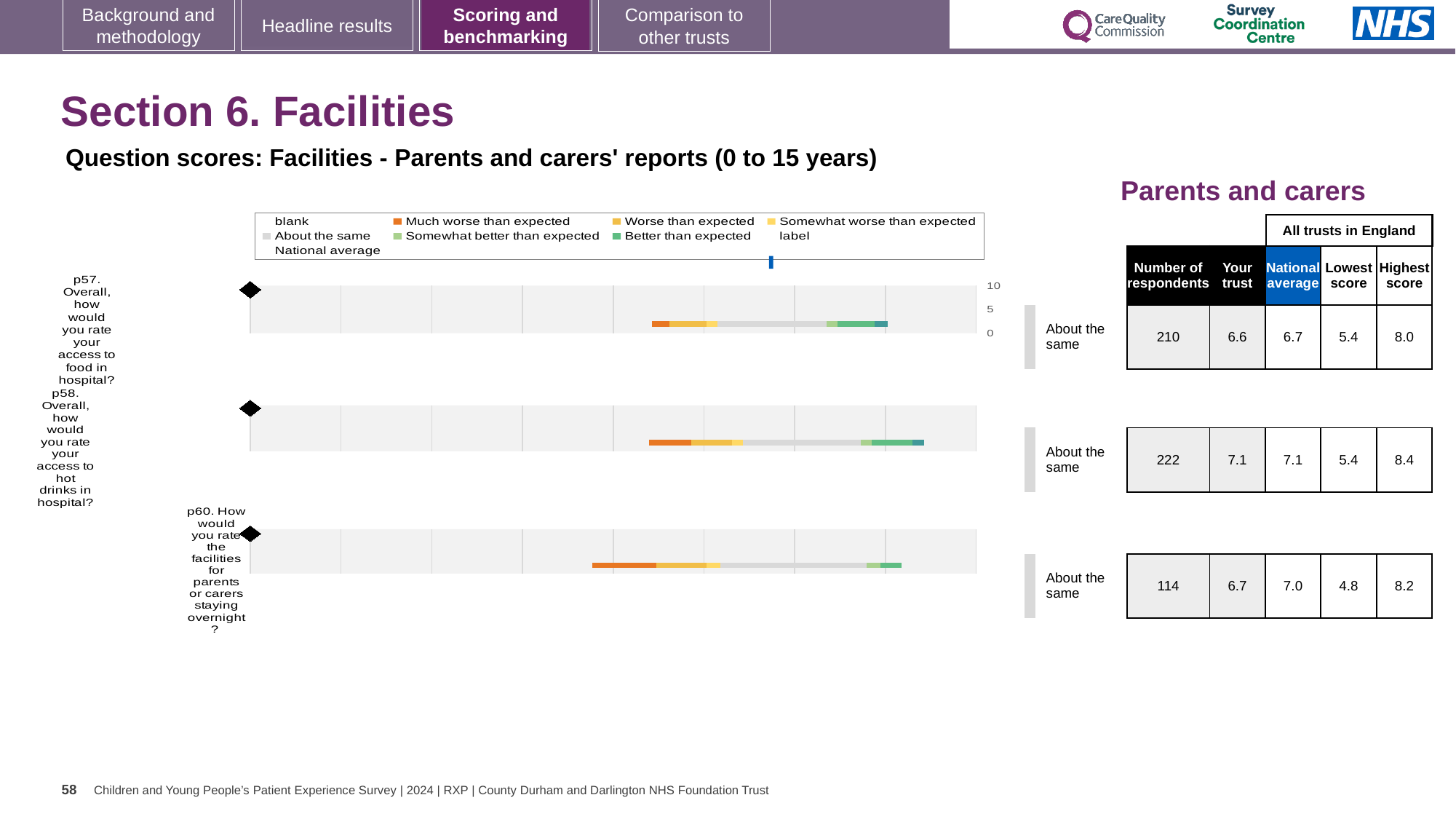
What is the difference between the highest score and the lowest score for p60? 3.4 For p57, which is larger: the 'Your trust' score or the national average? National average What is the highest score across all trusts in England for p58? 8.4 How many questions (categories) are plotted in the chart? 3 What is the 'Your trust' score for p57 (access to food in hospital)? 6.6 How many respondents answered p58 (access to hot drinks in hospital)? 222 What kind of chart is used to show the question scores on this slide? bar chart What benchmark category is shown next to each of the three questions? About the same Is the 'Your trust' score for p57 greater or less than 5 on the chart axis? greater Which question has the fewest respondents? p60. How would you rate the facilities for parents or carers staying overnight? What is the national average score for p60 (facilities for parents or carers staying overnight)? 7.0 Which question has the highest 'Your trust' score? p58. Overall, how would you rate your access to hot drinks in hospital?